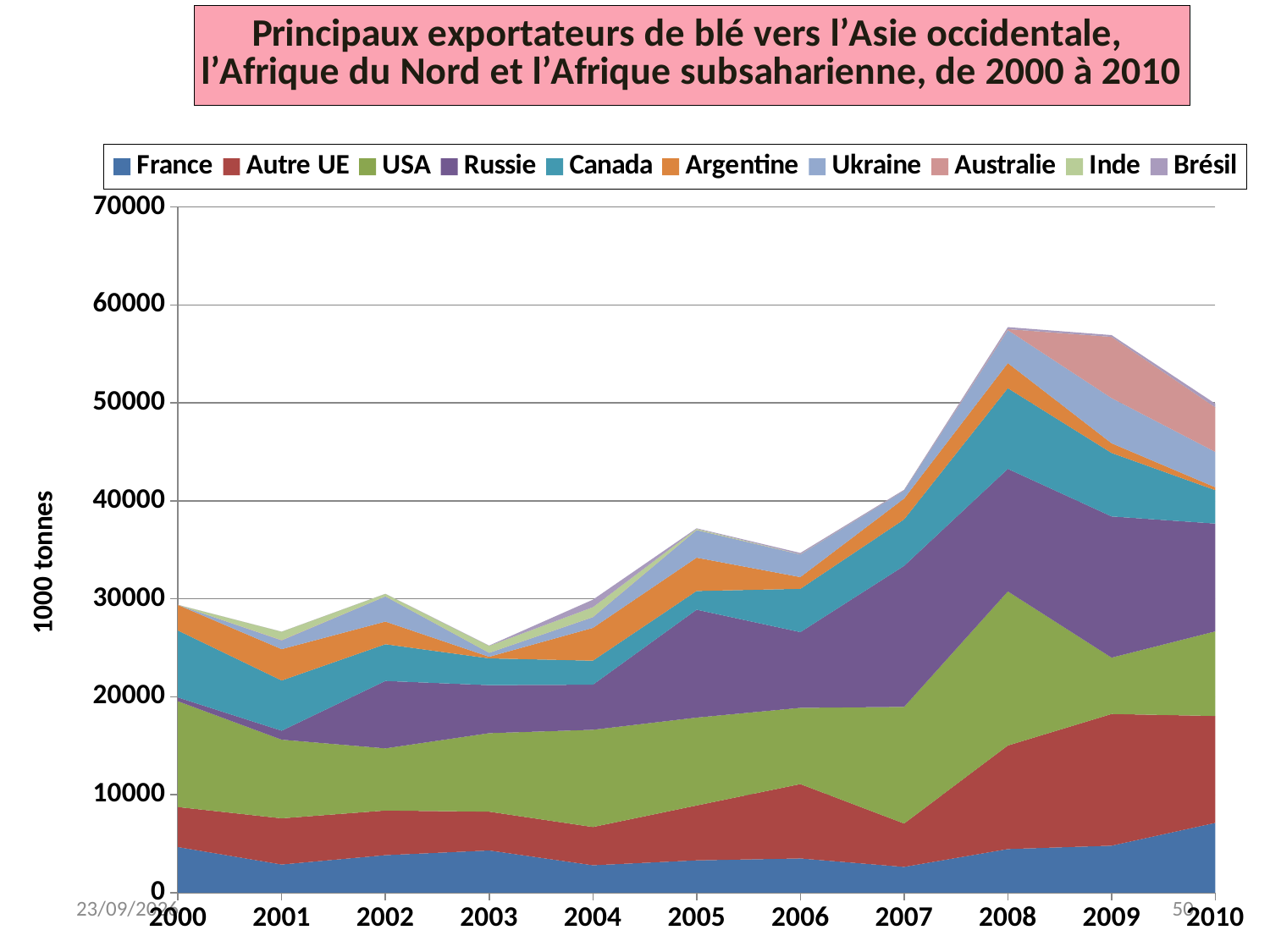
How many years are shown along the x axis? 11 What kind of chart is shown on the slide? stacked area chart Is the total for all exporters in 2008 greater or less than 50000? greater Is the value for France in 2010 greater or less than 5000? greater Is the total for all exporters in 2003 greater or less than 30000? less How many series does the legend list? 10 What is the label of the vertical axis? 1000 tonnes Is the total for all exporters larger in 2008 or in 2002? 2008 Which series is plotted at the bottom of the stack? France In which year is the total of all exporters highest? 2008 Does the total of all exporters rise or fall from 2008 to 2010? fall